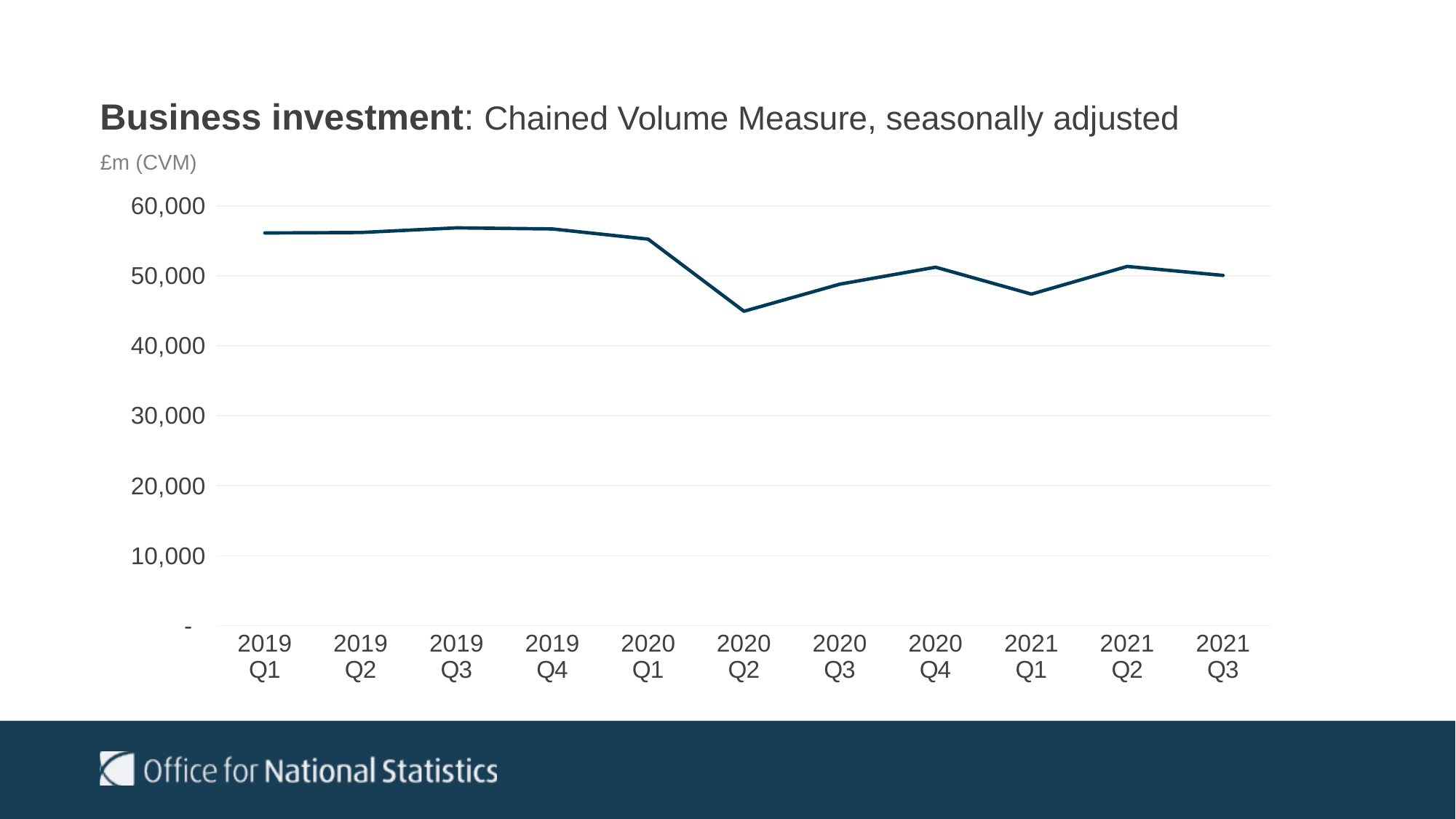
Which quarter has the lowest business investment value? 2020 Q2 What kind of chart is shown on the slide? line chart Is the value for 2020 Q2 greater or less than 50,000? less Is the value for 2019 Q3 greater or less than 60,000? less Which is larger, the value for 2020 Q4 or the value for 2021 Q1? 2020 Q4 Does the line rise or fall between 2020 Q1 and 2020 Q2? fall What is the title of the chart? Business investment: Chained Volume Measure, seasonally adjusted How many quarters are plotted along the x axis? 11 What unit is shown on the y axis label? £m (CVM) Which is larger, the value for 2019 Q1 or the value for 2020 Q2? 2019 Q1 Is the value for 2019 Q1 greater or less than 50,000? greater